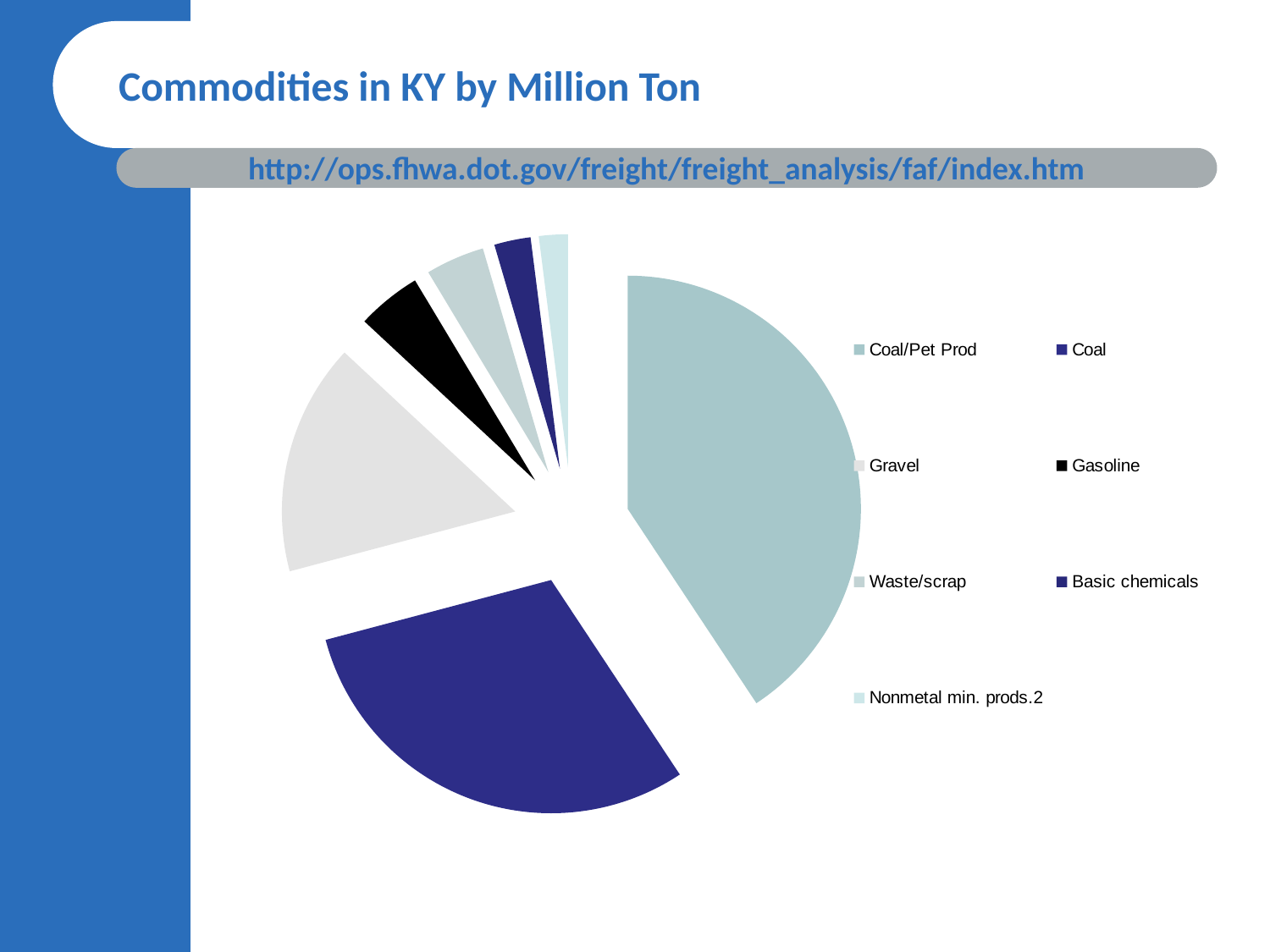
Which slice is larger, Coal or Gasoline? Coal What is the title of the slide containing the pie chart? Commodities in KY by Million Ton What colour is the Gasoline slice in the pie chart? black Which slice is larger, Gravel or Waste/scrap? Gravel How many entries does the legend of the pie chart list? 7 Which commodity has the largest slice in the pie chart? Coal/Pet Prod What kind of chart is shown on the slide? pie chart Which slice is larger, Coal/Pet Prod or Gravel? Coal/Pet Prod How many slices does the pie chart have? 7